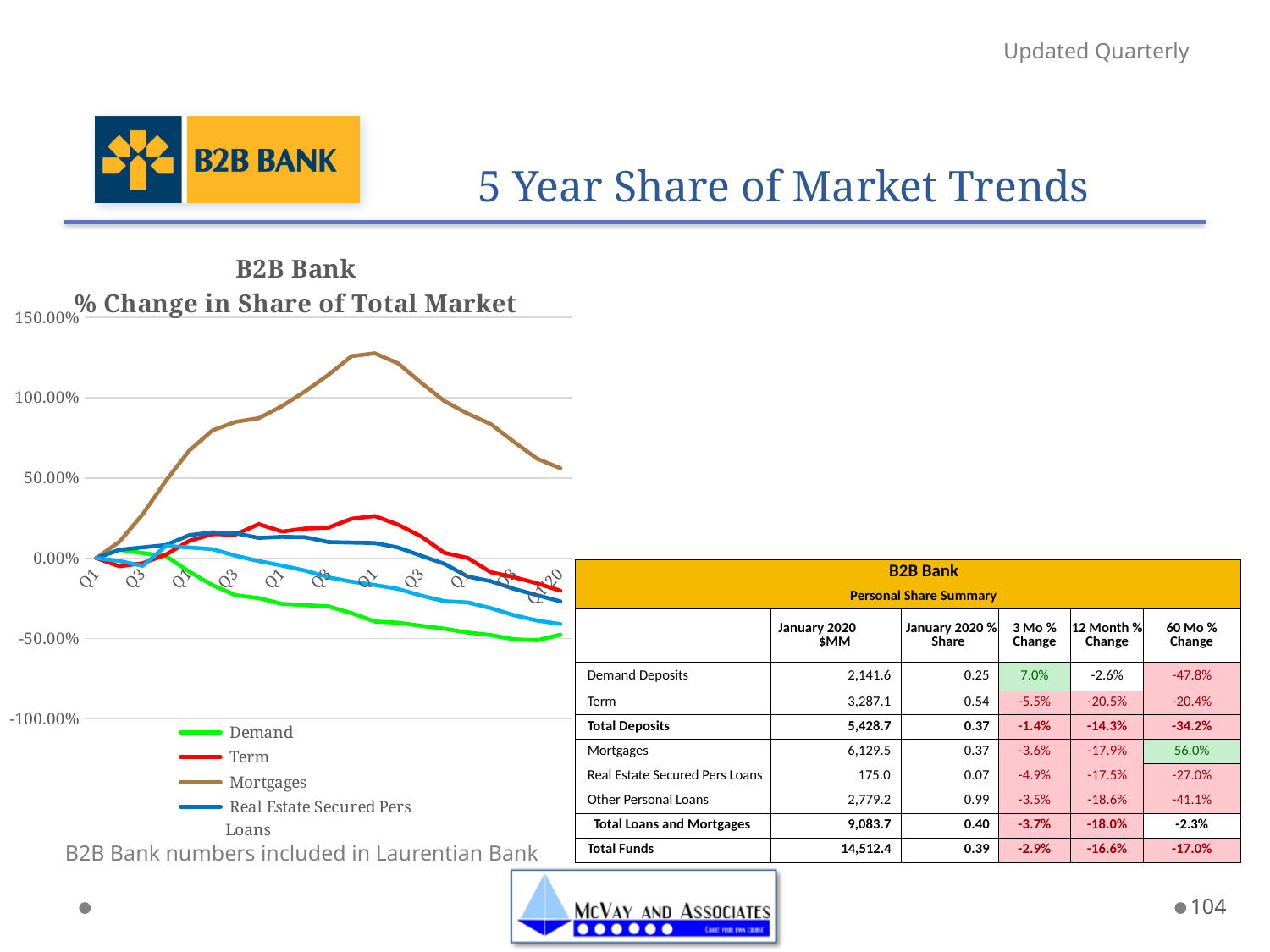
How many series does the legend of the chart list? 4 At the right end of the chart, which is higher, the Mortgages line or the Demand line? Mortgages Is the peak value of the Mortgages line greater or less than 100.00%? greater What colour is the Mortgages line in the chart? brown Which series reaches the highest value on the chart? Mortgages Does the Demand line generally rise or fall along the x axis? fall Is the final value of the Real Estate Secured Pers Loans line greater or less than 0.00%? less What is the title of the chart? B2B Bank % Change in Share of Total Market What kind of chart is shown on the slide? line chart Is the peak value of the Term line greater or less than 50.00%? less Which series has the lowest value at the right end of the chart? Demand